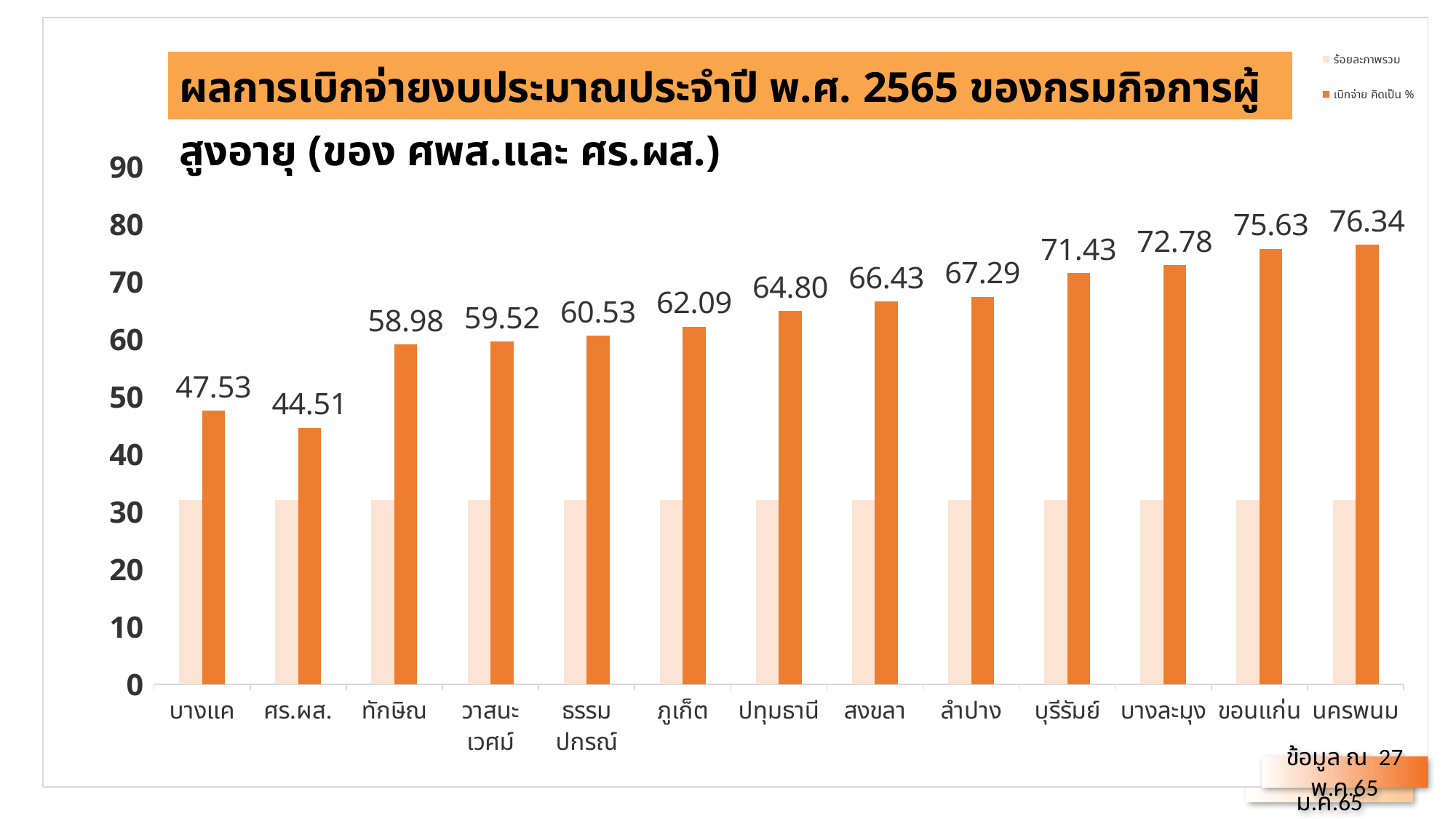
Which category has the lowest เบิกจ่าย คิดเป็น % value? ศร.ผส. Which has a higher เบิกจ่าย คิดเป็น % value, ลำปาง or สงขลา? ลำปาง How many categories are shown on the x axis? 13 What is the เบิกจ่าย คิดเป็น % value for ภูเก็ต? 62.09 What is the เบิกจ่าย คิดเป็น % value for นครพนม? 76.34 What is the เบิกจ่าย คิดเป็น % value for ศร.ผส.? 44.51 What kind of chart is shown on the slide? bar chart How many series does the legend list? 2 Which category has the highest เบิกจ่าย คิดเป็น % value? นครพนม Do the เบิกจ่าย คิดเป็น % values generally rise or fall from ศร.ผส. to นครพนม along the x axis? rise Is the ร้อยละภาพรวม value for บางแค greater or less than 40? less What is the difference between the เบิกจ่าย คิดเป็น % values for นครพนม and บางแค? 28.81